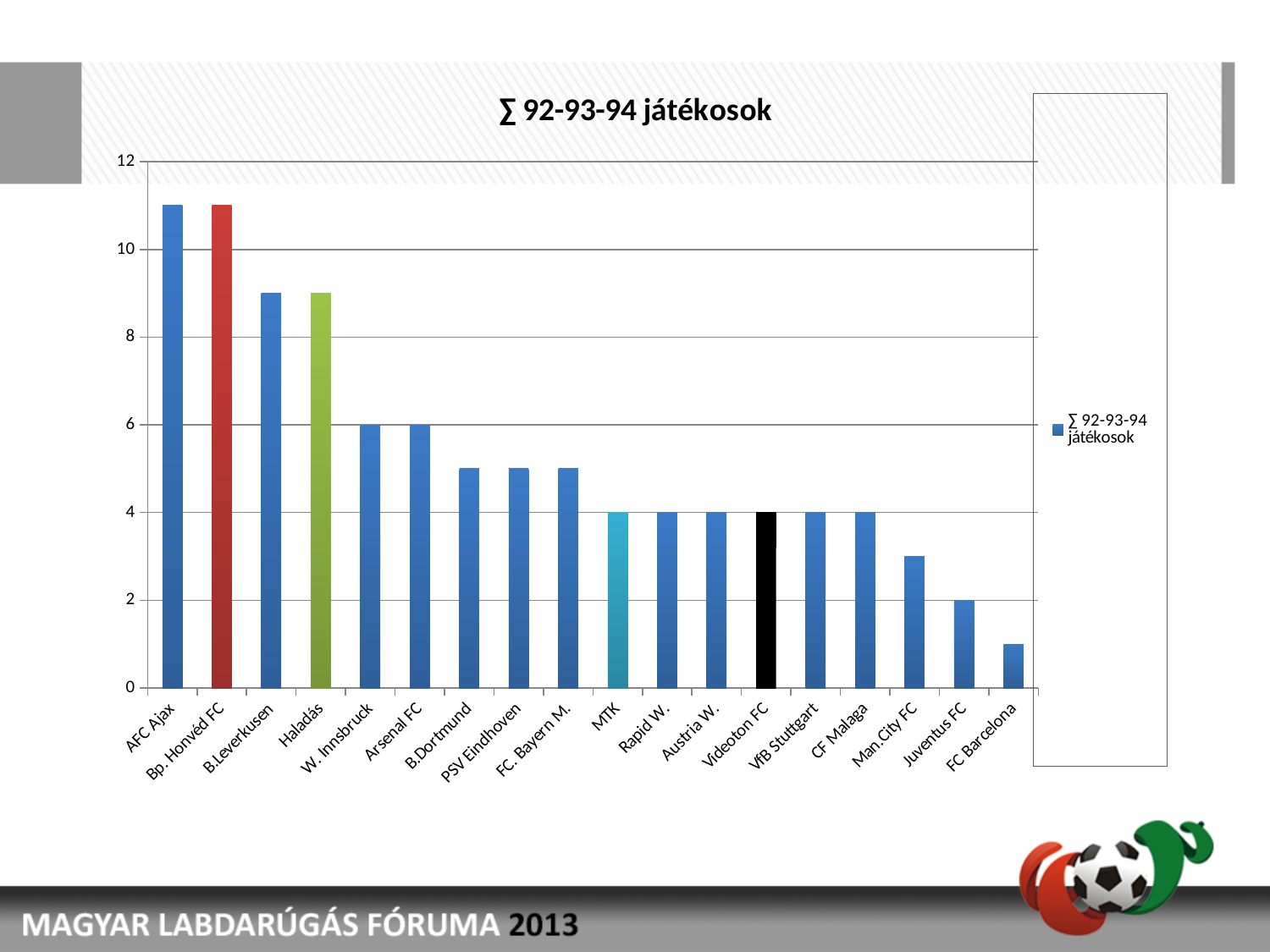
What is the value for W. Innsbruck? 6 How many series does the legend list? 1 Is the value for AFC Ajax greater or less than 10? greater How many clubs (categories) are shown on the x axis of the chart? 18 Which club has the lowest value in the chart? FC Barcelona What is the difference between the values for Arsenal FC and Juventus FC? 4 What is the title of the chart? ∑ 92-93-94 játékosok What is the value for Juventus FC? 2 What type of chart is shown on the slide? bar chart Which is larger, the value for B.Leverkusen or the value for B.Dortmund? B.Leverkusen What is the value for MTK? 4 Is the value for Man.City FC greater or less than 4? less